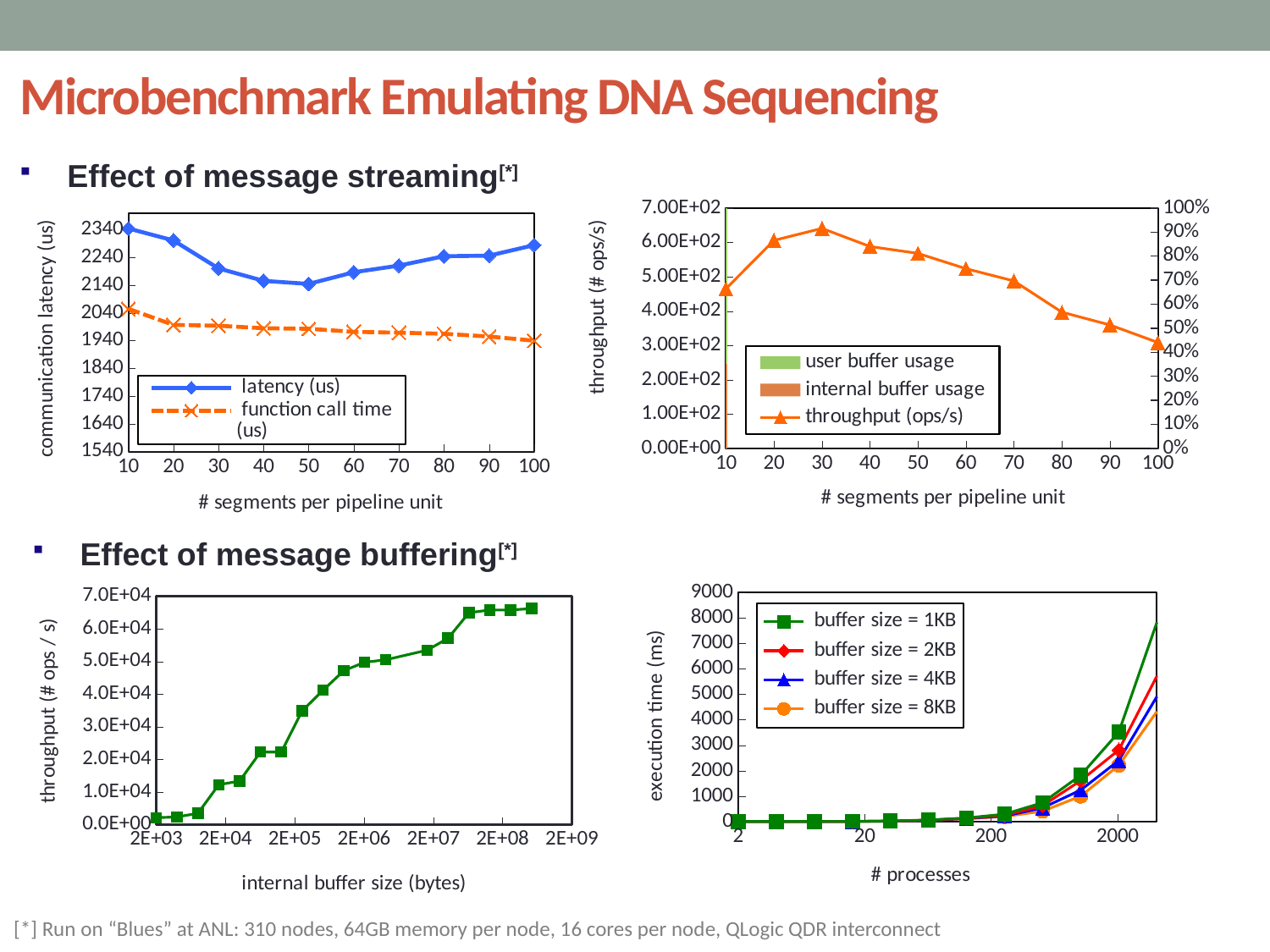
In the top-right throughput chart, is the throughput (ops/s) value at 100 segments greater or less than 4.00E+02? less What kind of chart is the top-left chart of communication latency versus # segments per pipeline unit? line chart In the top-left communication latency chart, how many series does the legend list? 2 In the top-right throughput chart, how many entries does the legend list? 3 In the top-left communication latency chart, is the latency (us) value at 10 segments greater or less than 2240? greater In the bottom-right execution time chart, which series has the highest execution time at the rightmost # processes value? buffer size = 1KB In the bottom-left chart of throughput versus internal buffer size, does throughput rise or fall as internal buffer size increases? rise In the top-left communication latency chart, at which # segments per pipeline unit is latency (us) highest? 10 In the top-right throughput chart, at which # segments per pipeline unit is throughput (ops/s) highest? 30 In the top-left communication latency chart, how many data points does the latency (us) series have? 10 In the bottom-right execution time chart, how many series does the legend list? 4 In the top-left communication latency chart, does function call time (us) rise or fall as # segments per pipeline unit increases? fall